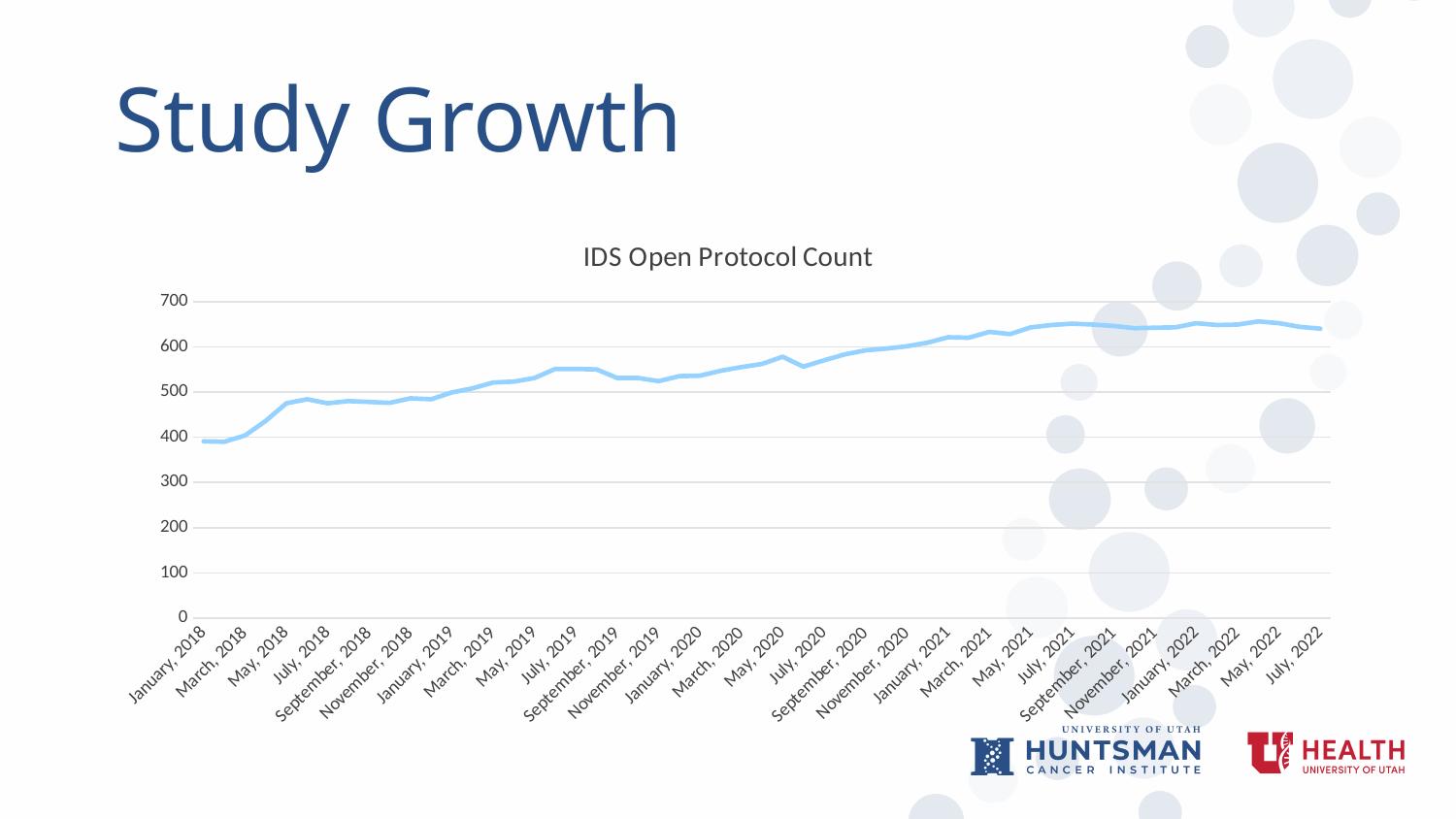
Is the value for January, 2020 greater or less than 600? less Overall, do the values rise or fall from January 2018 to July 2022? Rise Is the value for July, 2022 greater or less than 600? greater What is the title of the chart? IDS Open Protocol Count What type of chart is shown on the slide? Line chart Which is larger, the value for January, 2018 or the value for July, 2022? July, 2022 What is the highest value shown on the y axis? 700 Is the value for July, 2019 greater or less than 500? greater How many lines are plotted on the chart? 1